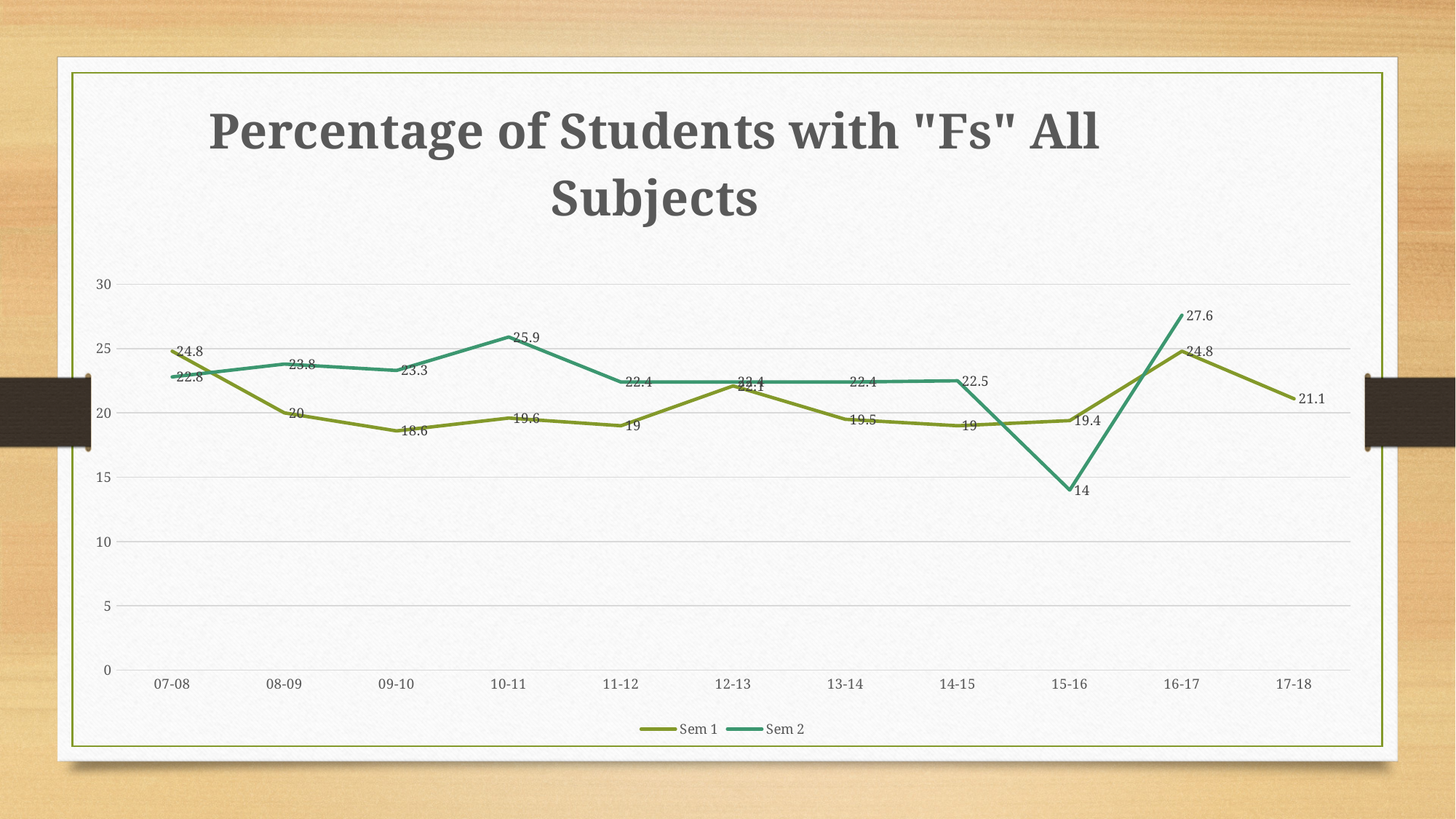
How many series does the legend list? 2 In which school year is the Sem 1 value lowest? 09-10 Which is larger for 12-13, the Sem 1 value or the Sem 2 value? Sem 2 What is the difference between the Sem 2 and Sem 1 values for 15-16? 5.4 In which school year is the Sem 2 value highest? 16-17 What type of chart is shown on the slide? line chart What is the title of the chart? Percentage of Students with "Fs" All Subjects What is the Sem 1 value for 09-10? 18.6 How many school years are shown on the x axis? 11 In which school year is the Sem 2 value lowest? 15-16 What is the Sem 2 value for 10-11? 25.9 What is the Sem 1 value for 17-18? 21.1